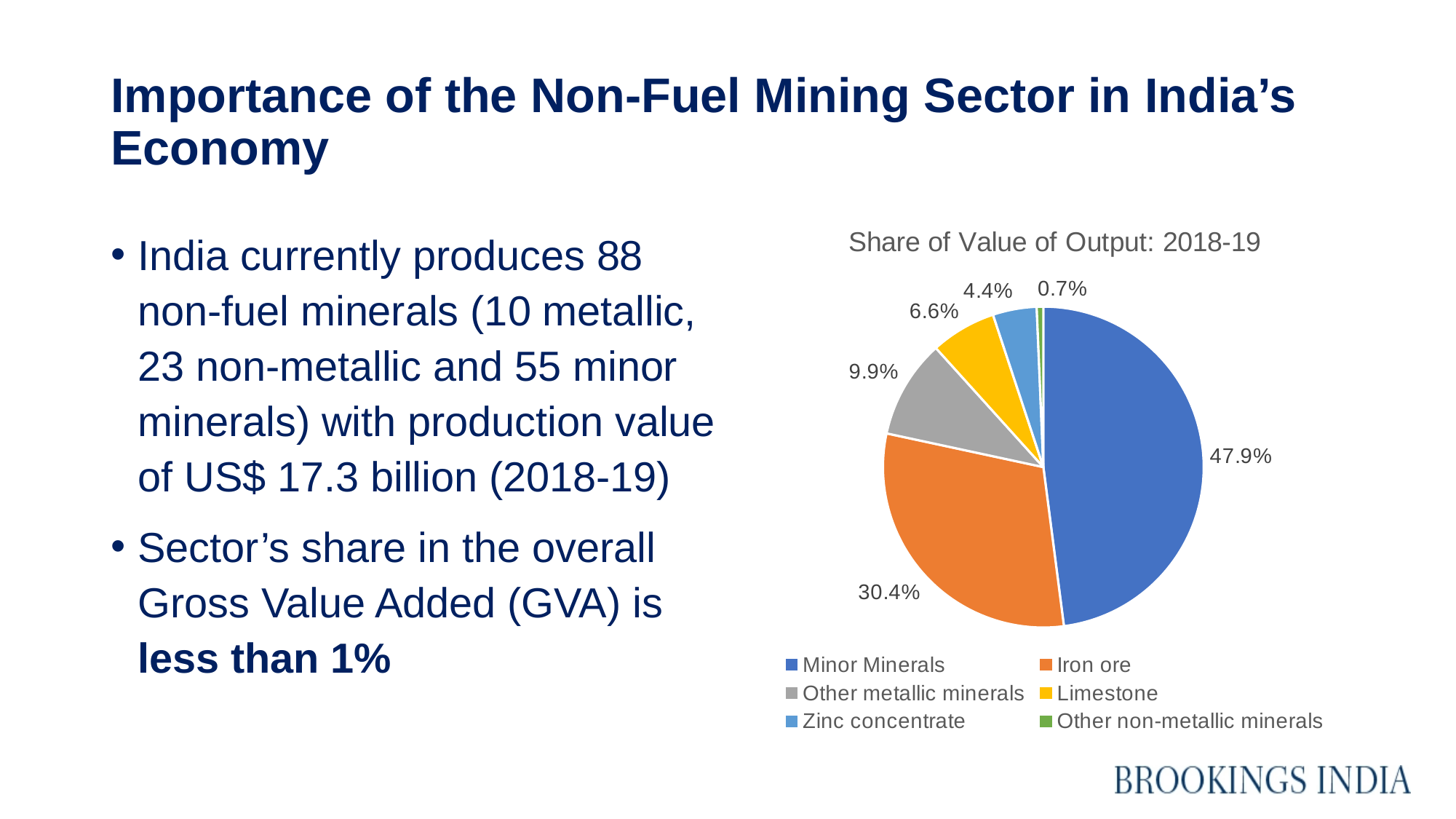
What kind of chart is shown on the slide? Pie chart What is the difference in share between Minor Minerals and Iron ore in the pie chart? 17.5% What share of value of output does Zinc concentrate have in the pie chart? 4.4% What share of value of output does Limestone have in the pie chart? 6.6% What share of value of output does Iron ore have in the pie chart? 30.4% What is the title of the chart on the slide? Share of Value of Output: 2018-19 Which category has the smallest share of value of output in the pie chart? Other non-metallic minerals How many categories does the pie chart show? 6 Which category has the largest share of value of output in the pie chart? Minor Minerals What colour represents Iron ore in the pie chart? Orange Which has a larger share of value of output, Limestone or Zinc concentrate? Limestone What share of value of output do Other metallic minerals have in the pie chart? 9.9%